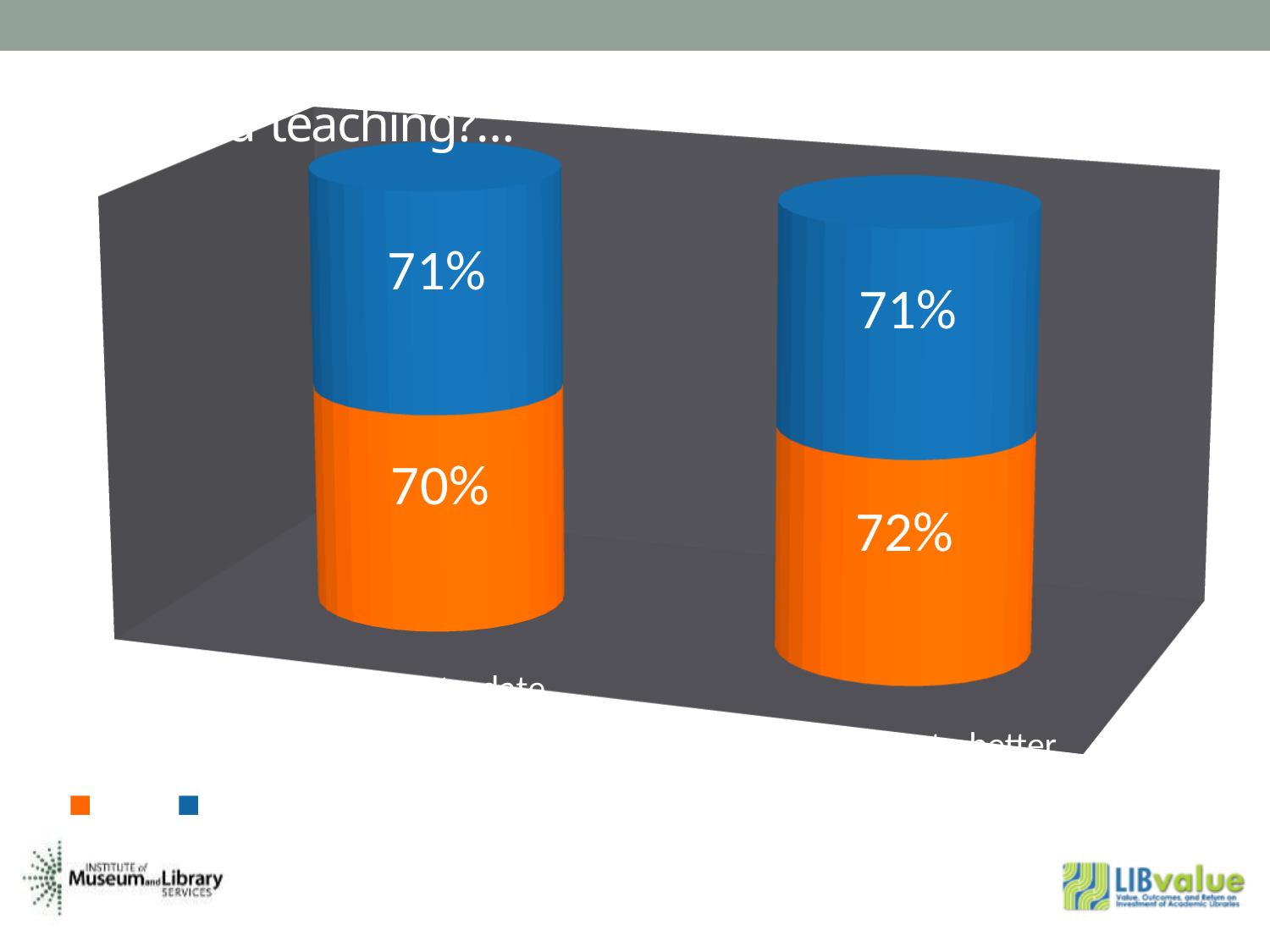
What is the value of the orange segment of the right bar? 72% What is the total of the two segments in the right bar? 143% What colour is the bottom segment of each bar? orange What is the value of the orange segment of the left bar? 70% Which bar has the larger orange segment, the left bar or the right bar? the right bar How many series does the legend list? 2 What is the difference between the orange segment of the right bar and the orange segment of the left bar? 2% How many bars are plotted in the chart? 2 What is the value of the blue segment of the right bar? 71% What is the value of the blue segment of the left bar? 71% What kind of chart is shown on the slide? stacked bar chart In the left bar, what is the difference between the blue segment and the orange segment? 1%